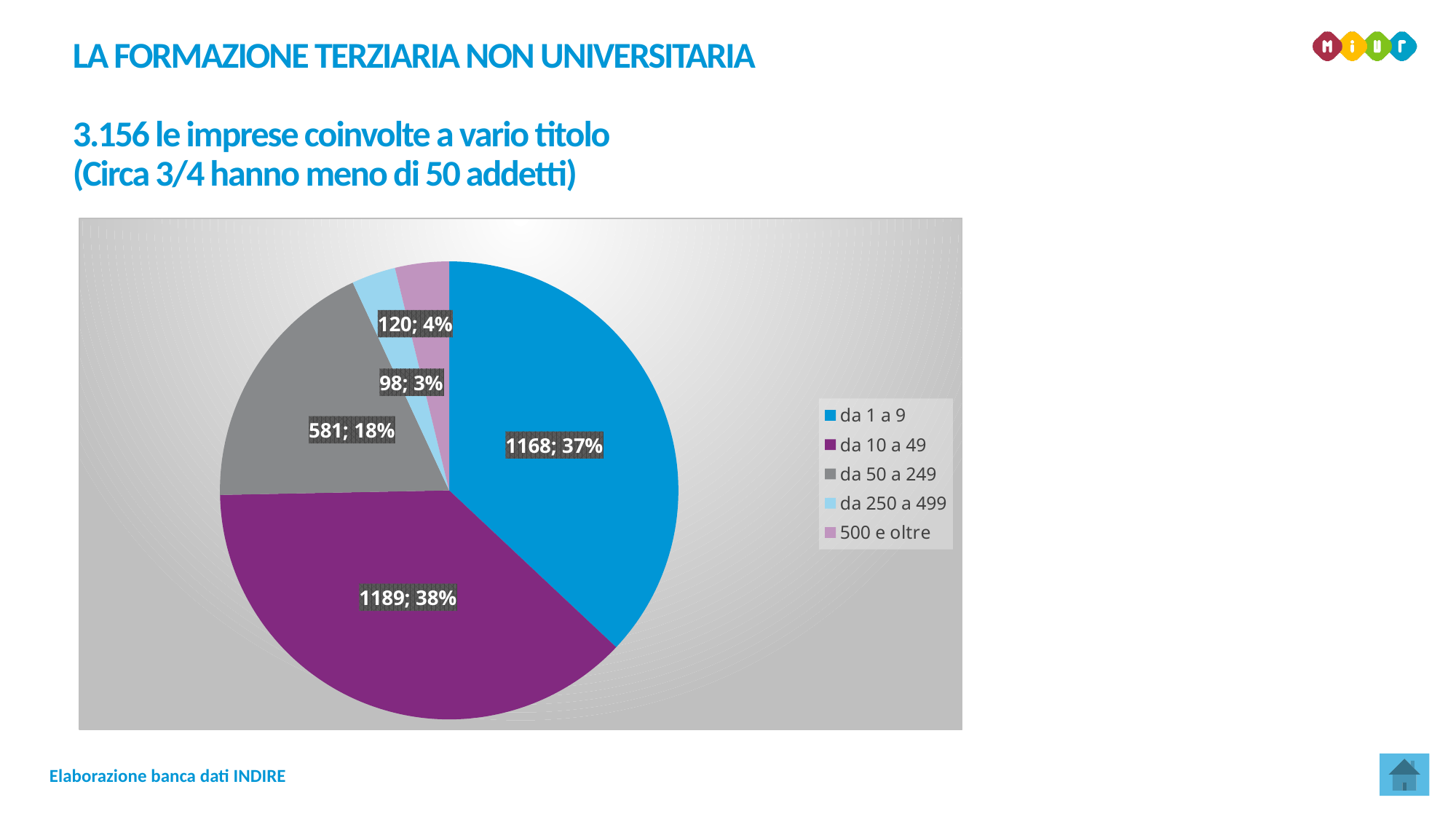
What is the value for 'da 50 a 249'? 581 What type of chart is shown on the slide? pie chart What percentage share does '500 e oltre' have? 4% What is the total of all the values in the pie chart? 3156 Which category has the largest value? da 10 a 49 What is the value for 'da 1 a 9'? 1168 How many slices does the pie chart have? 5 Which is larger, the value for '500 e oltre' or 'da 250 a 499'? 500 e oltre Which category has the smallest value? da 250 a 499 What percentage share does 'da 10 a 49' have? 38% What is the difference between the values for 'da 10 a 49' and 'da 1 a 9'? 21 How many entries does the legend list? 5